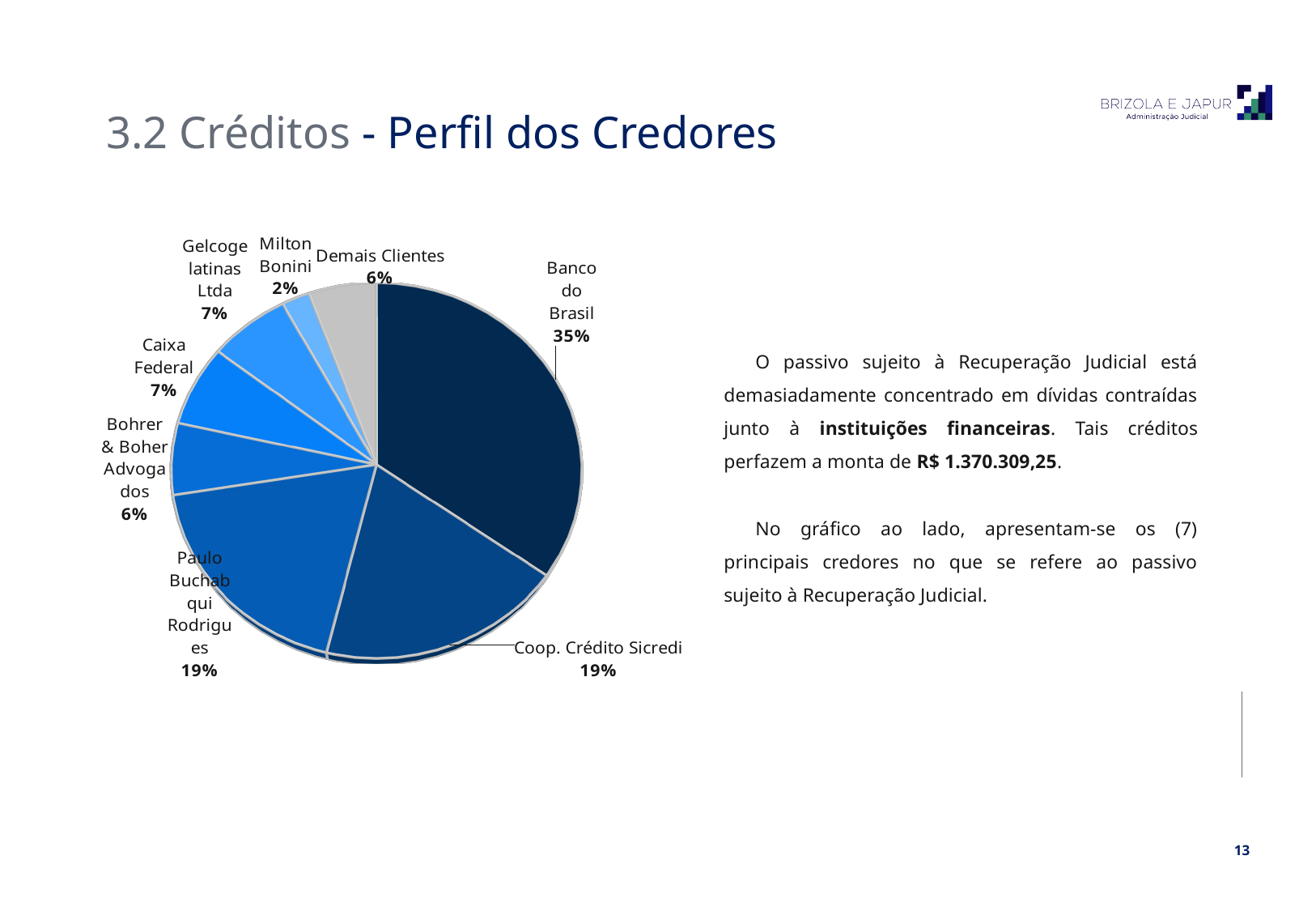
How many slices does the pie chart have? 8 What share of the pie does Banco do Brasil hold? 35% What share of the pie does Caixa Federal hold? 7% Which slice of the pie is the largest? Banco do Brasil What kind of chart is shown on the slide? pie chart Which slice of the pie is the smallest? Milton Bonini What is the title of the slide containing the pie chart? 3.2 Créditos - Perfil dos Credores What is the difference in percentage points between Banco do Brasil and Coop. Crédito Sicredi? 16 What share of the pie does Coop. Crédito Sicredi hold? 19% Which is larger, the share for Caixa Federal or the share for Bohrer & Boher Advogados? Caixa Federal